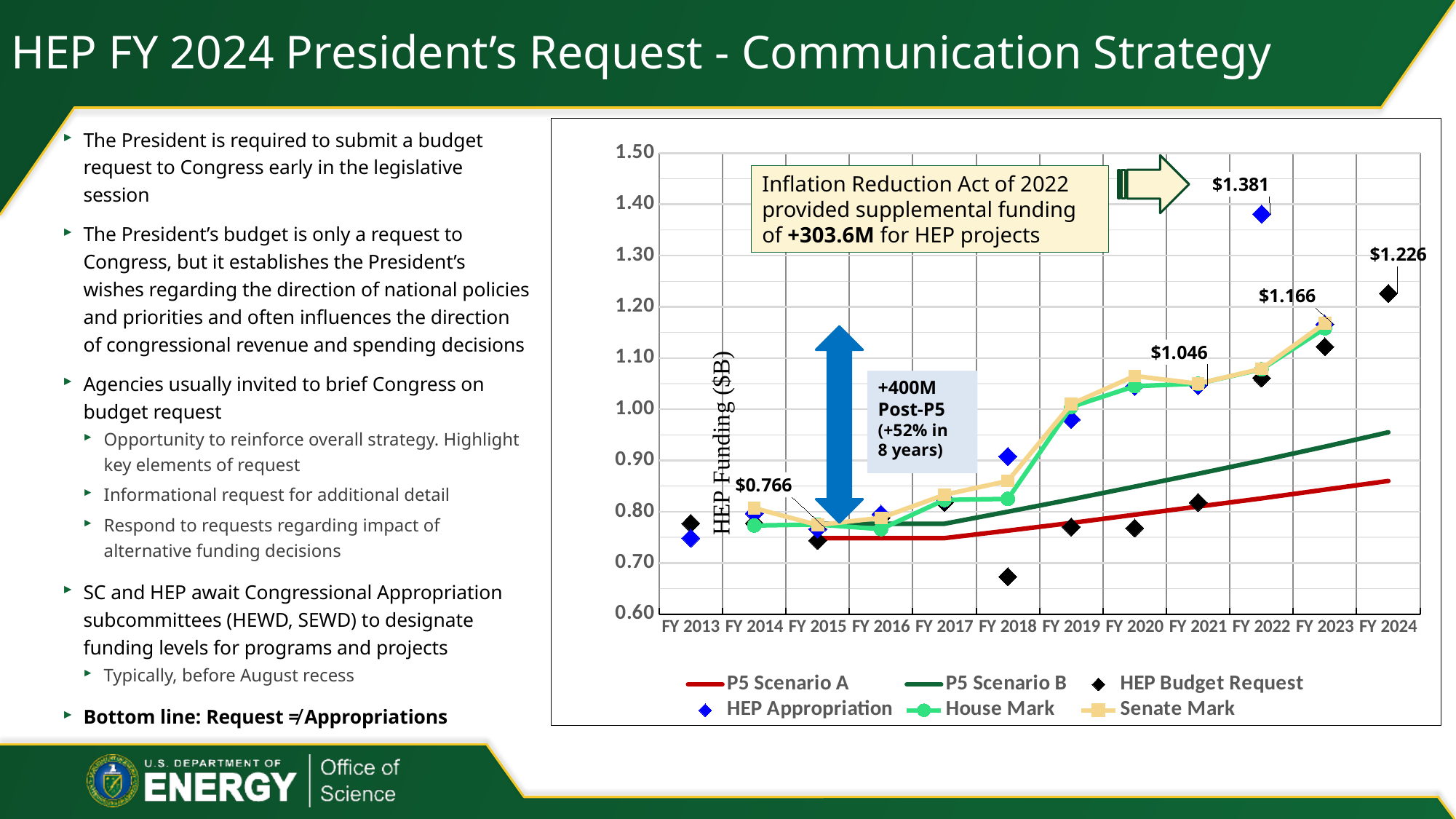
Does the P5 Scenario B line rise or fall from FY 2017 to FY 2024? rise What is the title of the y axis? HEP Funding ($B) What is the labeled HEP Appropriation value for FY 2022? $1.381 How many series does the chart legend list? 6 What is the labeled value for FY 2015 on the chart? $0.766 What is the labeled value for FY 2023 on the chart? $1.166 Is the HEP Budget Request value for FY 2018 greater or less than 0.70? less What is the labeled HEP Budget Request value for FY 2024? $1.226 What kind of chart is shown on the slide? line chart How many fiscal years are shown on the x axis? 12 What is the difference between the labeled FY 2022 value ($1.381) and the labeled FY 2023 value ($1.166)? $0.215